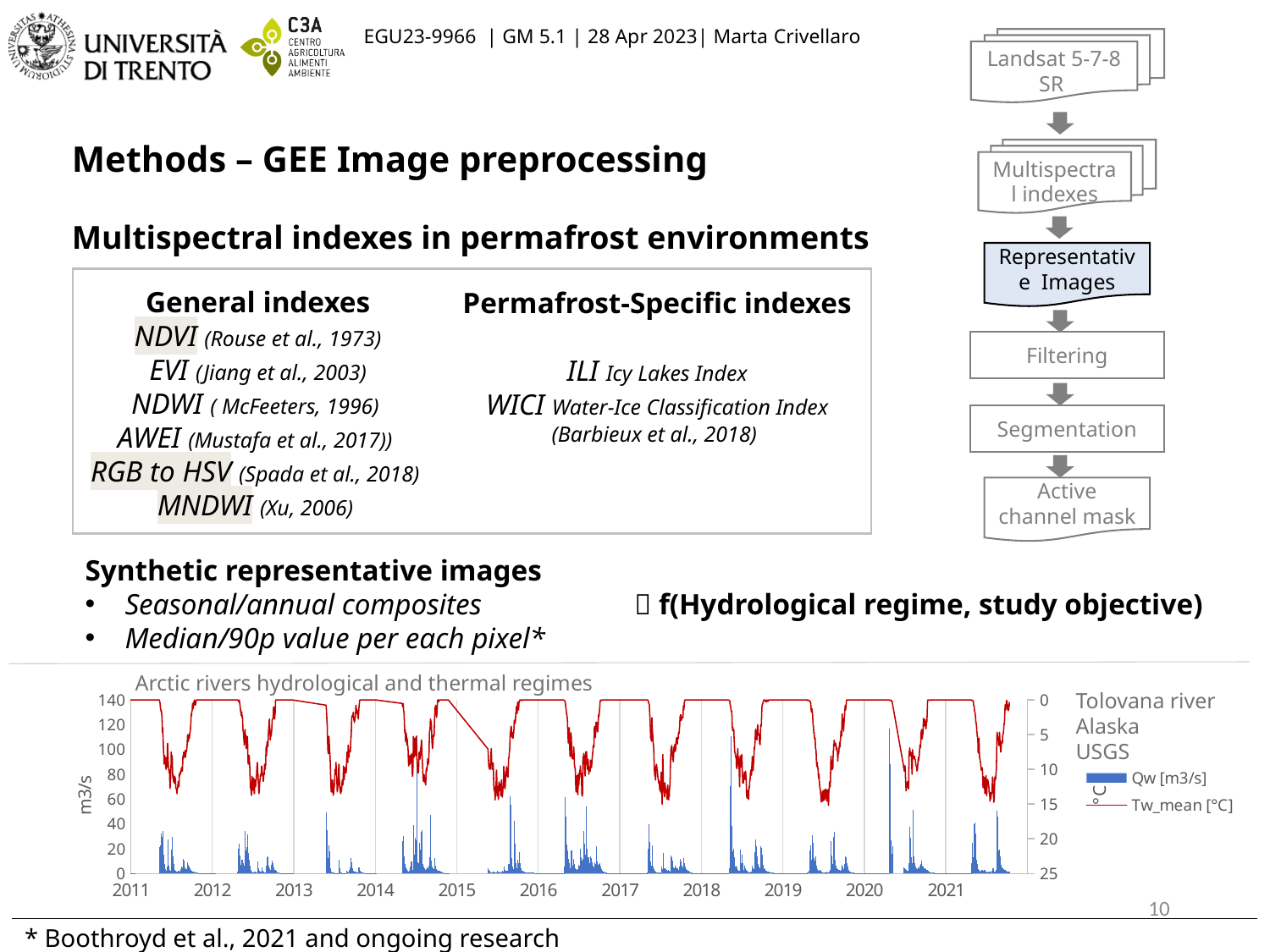
How many series does the legend of the 'Arctic rivers hydrological and thermal regimes' chart list? 2 What is the title of the chart at the bottom of the slide? Arctic rivers hydrological and thermal regimes Is the Qw [m3/s] value at the start of 2011 greater or less than 20? less What kind of chart is shown at the bottom of the slide? combination chart (a red line series with a blue filled area/bar series) How many year labels are shown along the x axis of the chart? 11 What is the last year shown on the x axis of the chart? 2021 What is the highest tick value on the left y axis (m3/s) of the chart? 140 What is the highest tick value on the right y axis (°C) of the chart? 25 Which series in the chart is drawn in red? Tw_mean [°C] Is the highest Qw [m3/s] peak in the chart greater or less than 80? greater What is the first year shown on the x axis of the chart? 2011